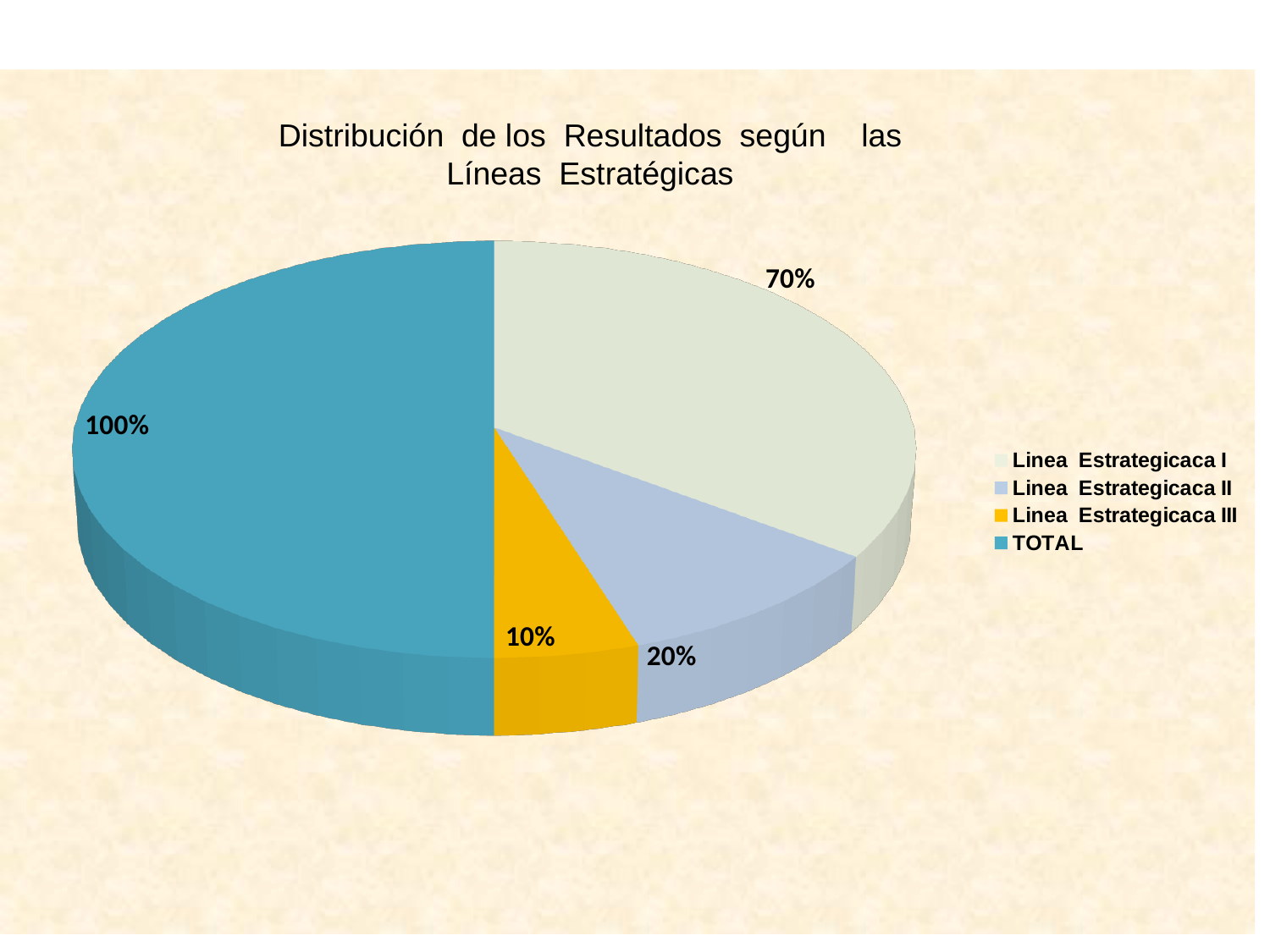
Which slice has the smallest labelled value? Linea Estrategicaca III How many entries does the legend list? 4 What colour is the TOTAL slice? teal blue What is the difference between the labelled values for Linea Estrategicaca I and Linea Estrategicaca II? 50% What value is labelled on the slice for Linea Estrategicaca I? 70% What value is labelled on the slice for Linea Estrategicaca II? 20% Which slice has the largest labelled value? TOTAL What value is labelled on the TOTAL slice? 100% What type of chart is shown on the slide? pie chart What is the title of the chart? Distribución de los Resultados según las Líneas Estratégicas What value is labelled on the slice for Linea Estrategicaca III? 10% Which has the larger labelled value, Linea Estrategicaca II or Linea Estrategicaca III? Linea Estrategicaca II